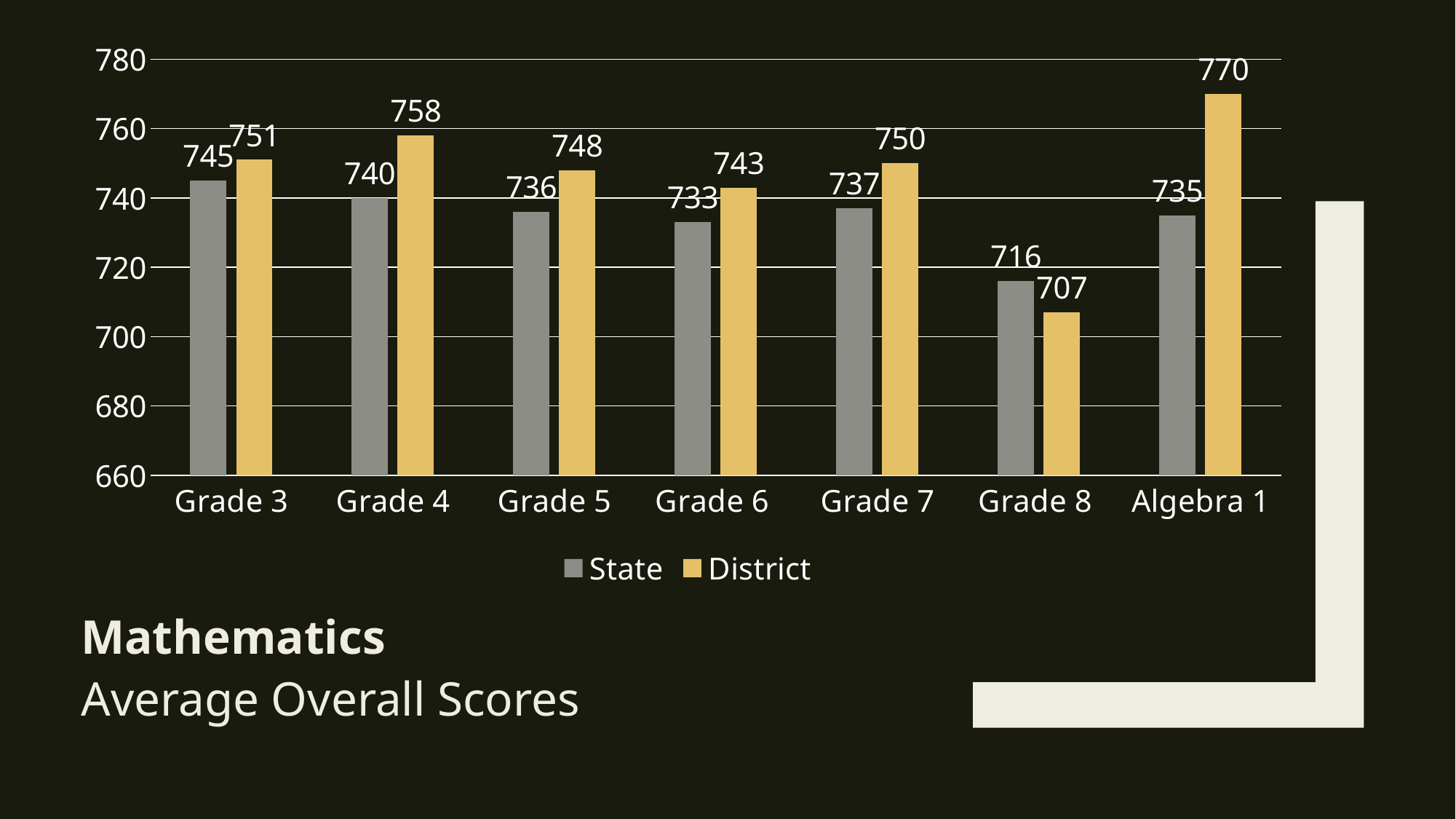
What is the difference between the State and District scores for Grade 8? 9 How many series does the legend list? 2 What is the State average overall score for Grade 8? 716 How many categories are shown on the x axis? 7 What is the State score for Algebra 1? 735 What is the difference between the District and State scores for Algebra 1? 35 What kind of chart is shown on the slide? Bar chart Which category has the lowest State score? Grade 8 What is the District average overall score for Grade 4? 758 For Grade 8, which is larger, the State score or the District score? State Which category has the highest District score? Algebra 1 Is the District score for Grade 7 greater or less than 740? greater